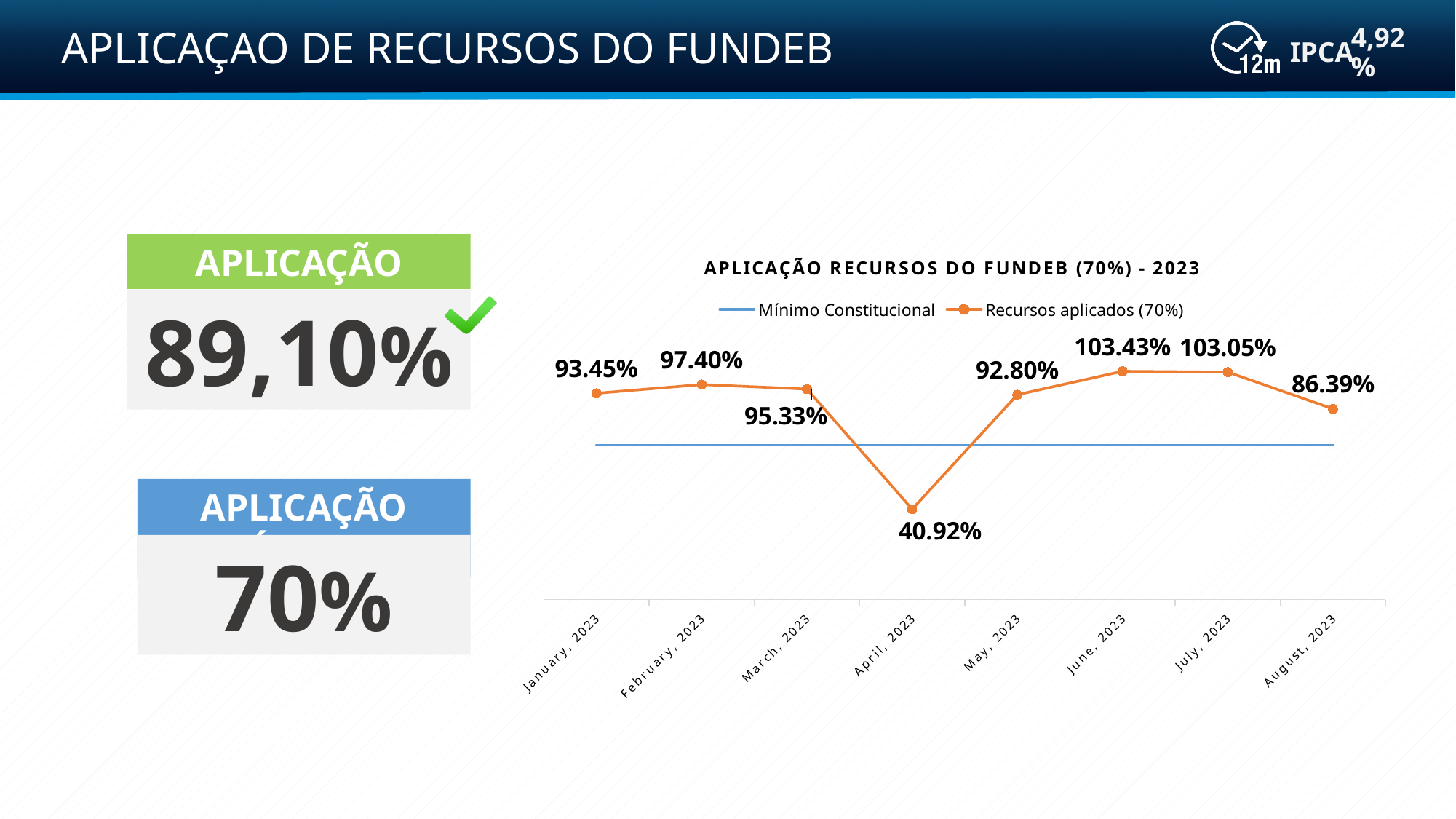
Which month has the lowest value for Recursos aplicados (70%)? April, 2023 What is the difference between the Recursos aplicados (70%) values for June, 2023 and April, 2023? 62.51% How many series does the chart legend list? 2 Does the Recursos aplicados (70%) value rise or fall from June, 2023 to August, 2023? Fall What is the difference between the Recursos aplicados (70%) values for February, 2023 and January, 2023? 3.95% What kind of chart is shown on the slide? Line chart How many months are plotted on the x axis of the chart? 8 Which month has the highest value for Recursos aplicados (70%)? June, 2023 What is the value of Recursos aplicados (70%) for February, 2023? 97.40% Which is larger, the Recursos aplicados (70%) value for March, 2023 or for May, 2023? March, 2023 What is the value of Recursos aplicados (70%) for August, 2023? 86.39% What is the value of Recursos aplicados (70%) for April, 2023? 40.92%